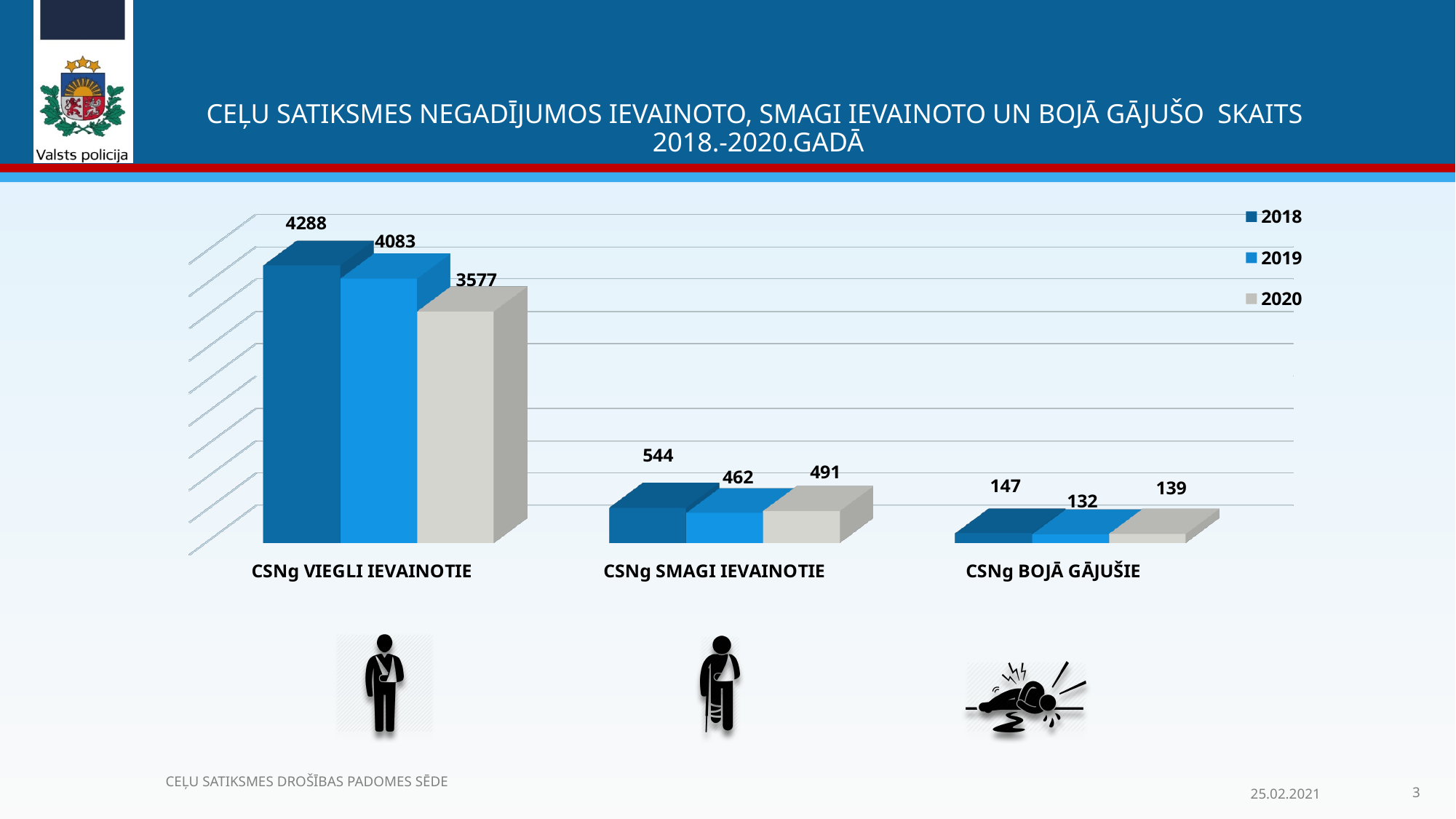
Which is larger for CSNg SMAGI IEVAINOTIE: the 2019 value or the 2020 value? 2020 How many series does the legend list? 3 What is the value for CSNg VIEGLI IEVAINOTIE in 2018? 4288 What is the value for CSNg SMAGI IEVAINOTIE in 2019? 462 Which category has the highest value in 2020? CSNg VIEGLI IEVAINOTIE Do the values for CSNg VIEGLI IEVAINOTIE rise or fall from 2018 to 2020? fall Which years are listed in the legend? 2018, 2019, 2020 How many categories are shown on the x axis? 3 What is the value for CSNg BOJĀ GĀJUŠIE in 2020? 139 What kind of chart is shown on the slide? bar chart Which category has the lowest value in 2018? CSNg BOJĀ GĀJUŠIE What is the difference between the 2018 and 2020 values for CSNg VIEGLI IEVAINOTIE? 711